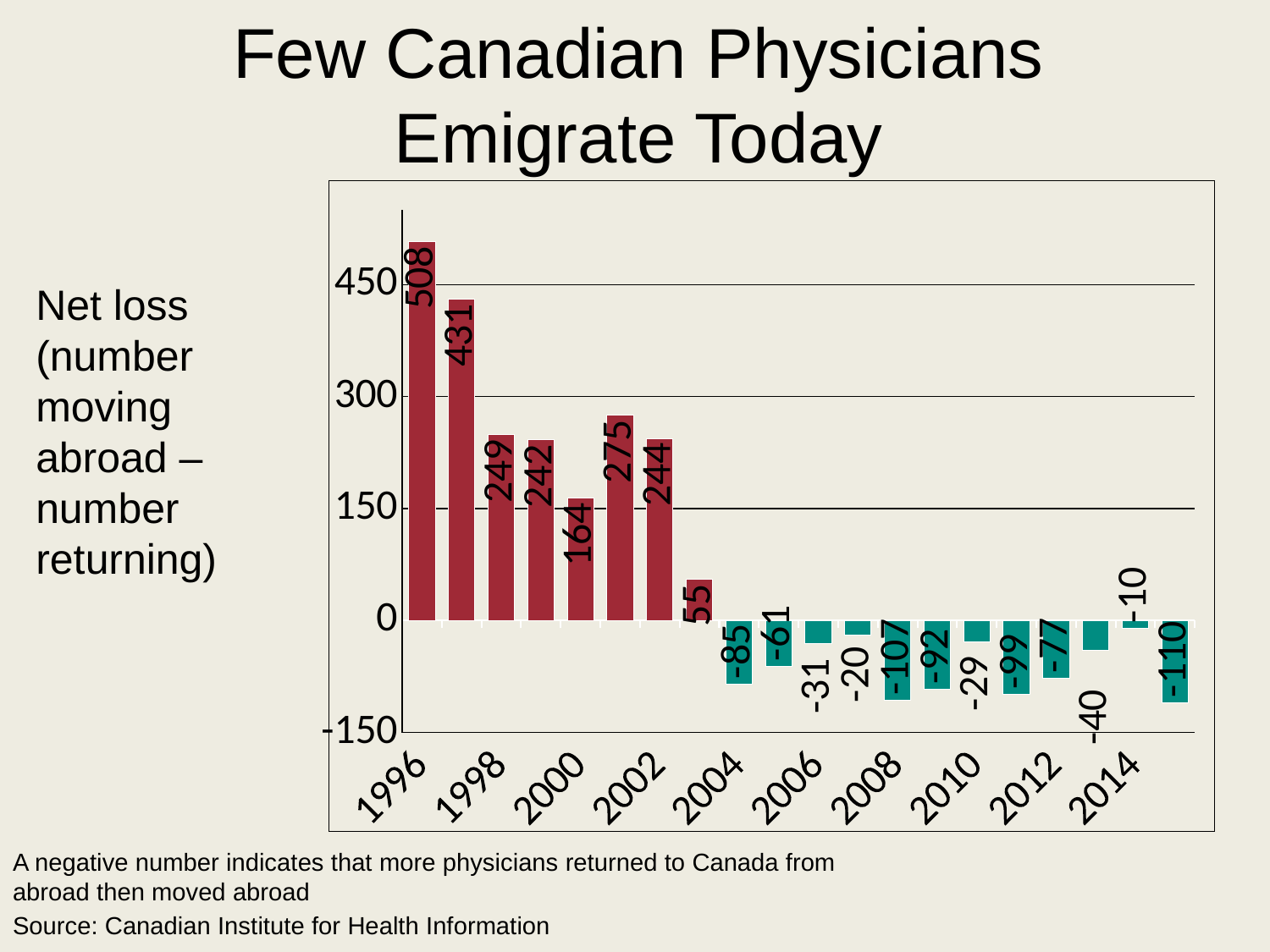
How many bars are plotted on the chart? 20 What kind of chart is shown on the slide? Bar chart What is the net loss value for 2008? -107 What is the net loss value for 2014? -10 What is the net loss value for 2000? 164 What is the net loss value for 1996? 508 Which year has the highest net loss value? 1996 Which is larger, the value for 2002 or the value for 2000? 2002 Is the value for 1996 greater or less than 450? greater Do the values generally rise or fall from 1996 to 2015? Fall What is the difference between the values for 1996 and 1998? 259 What is the lowest value shown on the chart? -110